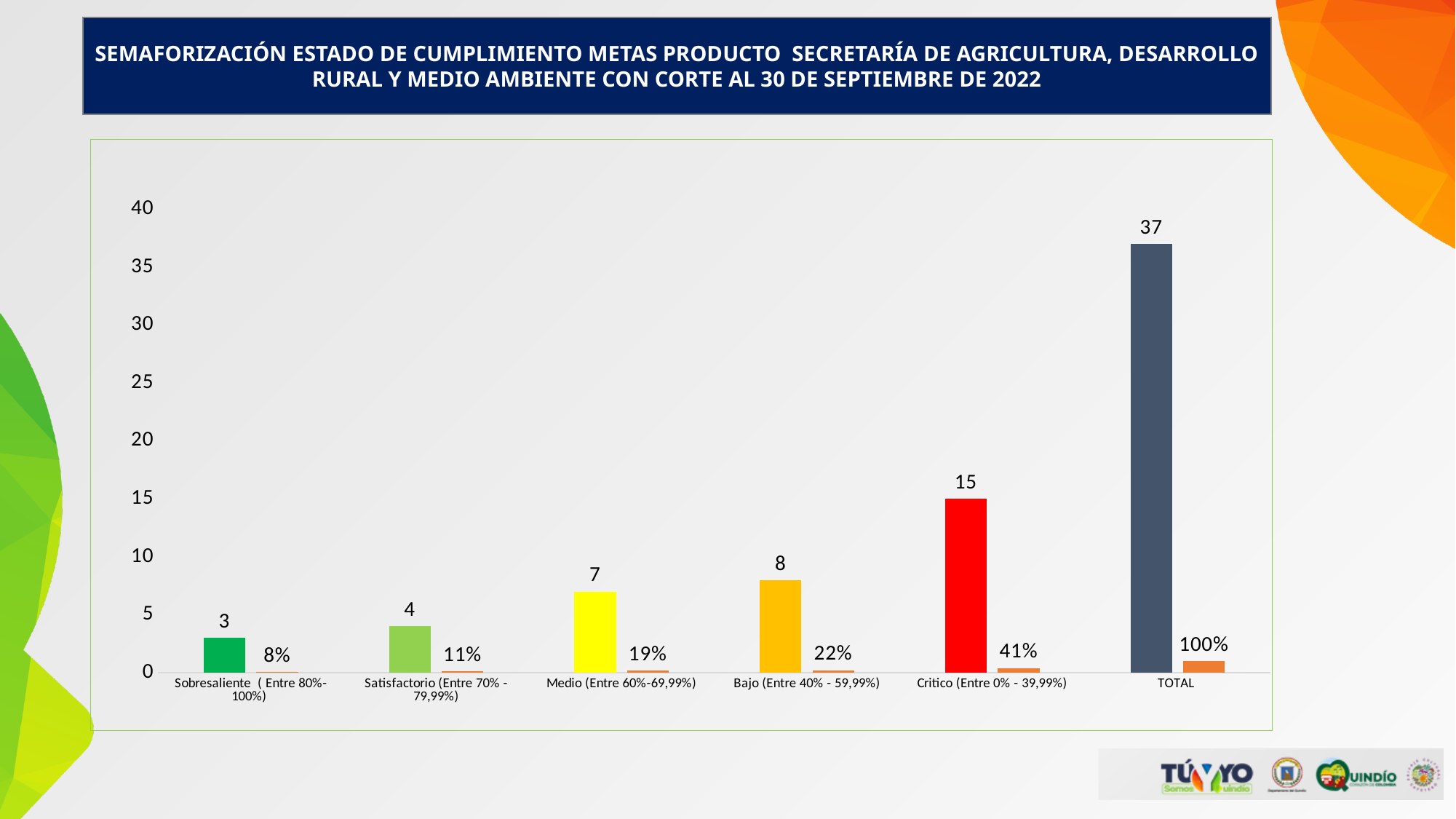
What kind of chart is shown on the slide? bar chart What is the difference between the number of metas in Critico and in Bajo? 7 How many categories are shown on the x axis of the chart? 6 What percentage is shown for the Sobresaliente (Entre 80%-100%) category? 8% What is the number of metas in the Critico (Entre 0% - 39,99%) category? 15 What percentage is shown for the Bajo (Entre 40% - 59,99%) category? 22% What is the number of metas in the Medio (Entre 60%-69,99%) category? 7 Which category has the lowest number of metas? Sobresaliente (Entre 80%-100%) Is the value for TOTAL greater or less than 35? greater Excluding TOTAL, which category has the highest number of metas? Critico (Entre 0% - 39,99%) What colour is the bar for the Critico category? red Which has more metas, Satisfactorio or Medio? Medio